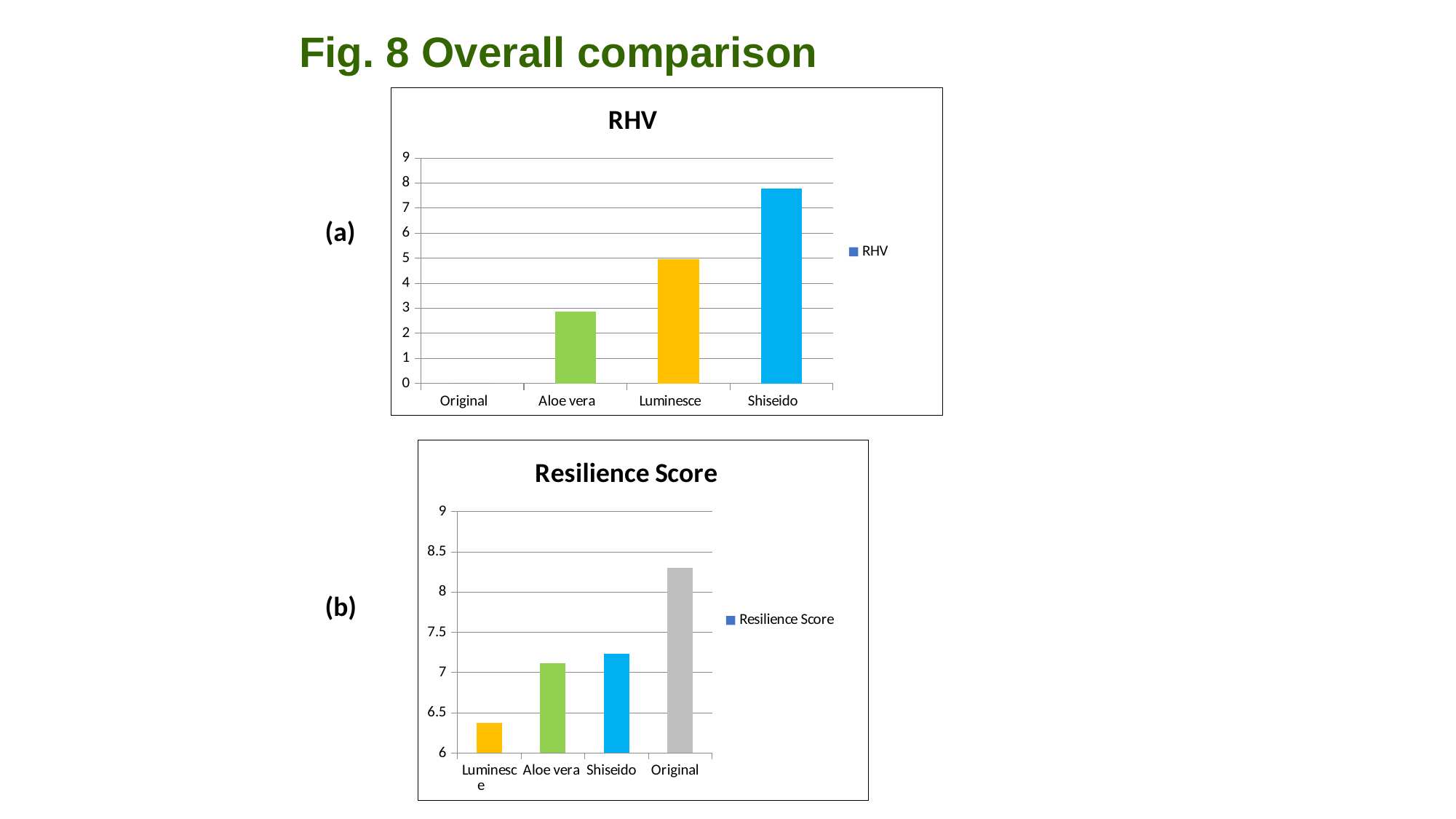
In the Resilience Score chart, which category has the lowest value? Luminesce In the Resilience Score chart, is the value for Original greater or less than 8? greater How many series does the legend of the Resilience Score chart list? 1 In the RHV chart, which is larger, the value for Aloe vera or the value for Luminesce? Luminesce In the Resilience Score chart, which category has the highest value? Original In the RHV chart, is the value for Shiseido greater or less than 7? greater In the RHV chart, which category has the highest value? Shiseido How many categories are shown on the x axis of the RHV chart? 4 In the RHV chart, which category has the lowest value? Original In the Resilience Score chart, is the value for Luminesce greater or less than 6.5? less What kind of chart is the Resilience Score chart? bar chart